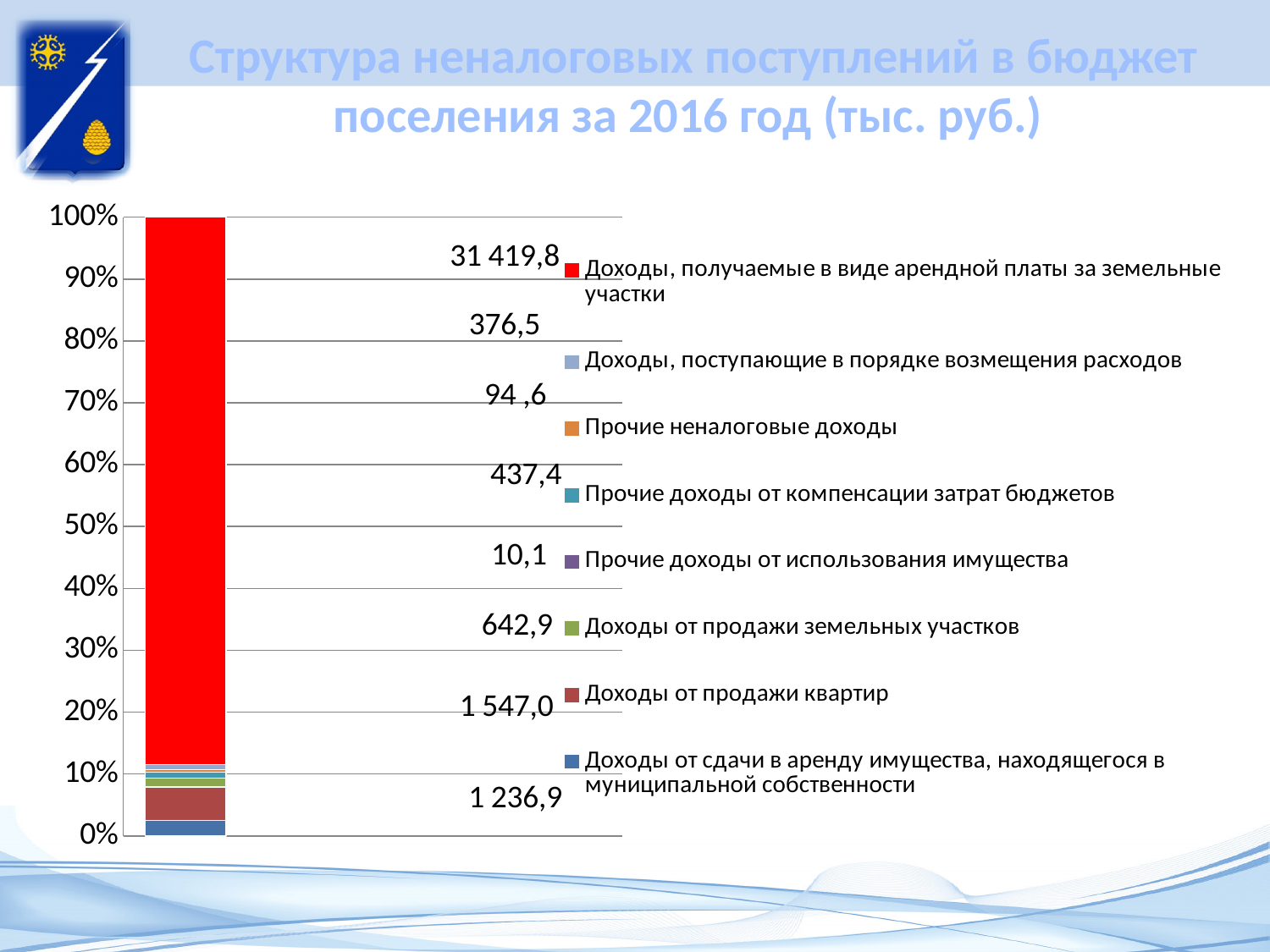
Which category has the highest value? Доходы, получаемые в виде арендной платы за земельные участки What is the title of the chart? Структура неналоговых поступлений в бюджет поселения за 2016 год (тыс. руб.) What is the value for «Прочие доходы от использования имущества»? 10,1 What is the value for «Доходы от продажи земельных участков»? 642,9 Which category has the lowest value? Прочие доходы от использования имущества What is the value for «Доходы, получаемые в виде арендной платы за земельные участки»? 31 419,8 What kind of chart is shown on the slide? Stacked bar chart What is the difference between «Доходы от продажи квартир» and «Доходы от сдачи в аренду имущества, находящегося в муниципальной собственности»? 310,1 What is the value for «Доходы от сдачи в аренду имущества, находящегося в муниципальной собственности»? 1 236,9 How many series does the legend list? 8 Which is larger: «Доходы от продажи земельных участков» or «Прочие доходы от компенсации затрат бюджетов»? Доходы от продажи земельных участков What is the value for «Доходы от продажи квартир»? 1 547,0